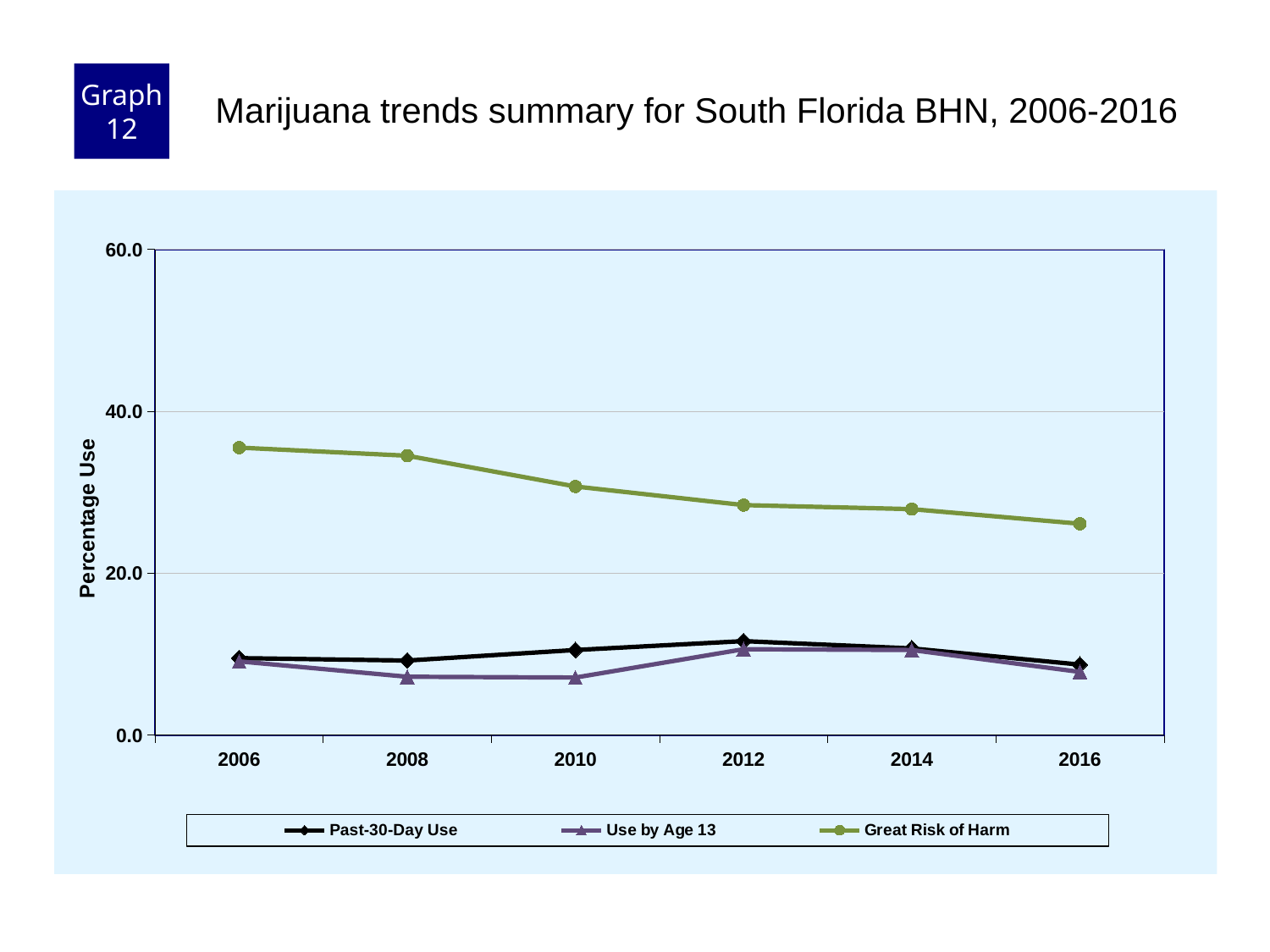
Is the Great Risk of Harm value for 2006 greater or less than 40.0? less Does the Great Risk of Harm series rise or fall from 2006 to 2016? fall How many series does the legend list? 3 What is the label on the y axis? Percentage Use How many years are plotted along the x axis? 6 What kind of chart is shown on the slide? line chart In 2010, which series has the larger value: Great Risk of Harm or Past-30-Day Use? Great Risk of Harm Is the Great Risk of Harm value for 2016 greater or less than 20.0? greater Is the Past-30-Day Use value for 2012 greater or less than 20.0? less In which year is the Great Risk of Harm value lowest? 2016 What is the title of the chart? Marijuana trends summary for South Florida BHN, 2006-2016 In which year is the Great Risk of Harm value highest? 2006